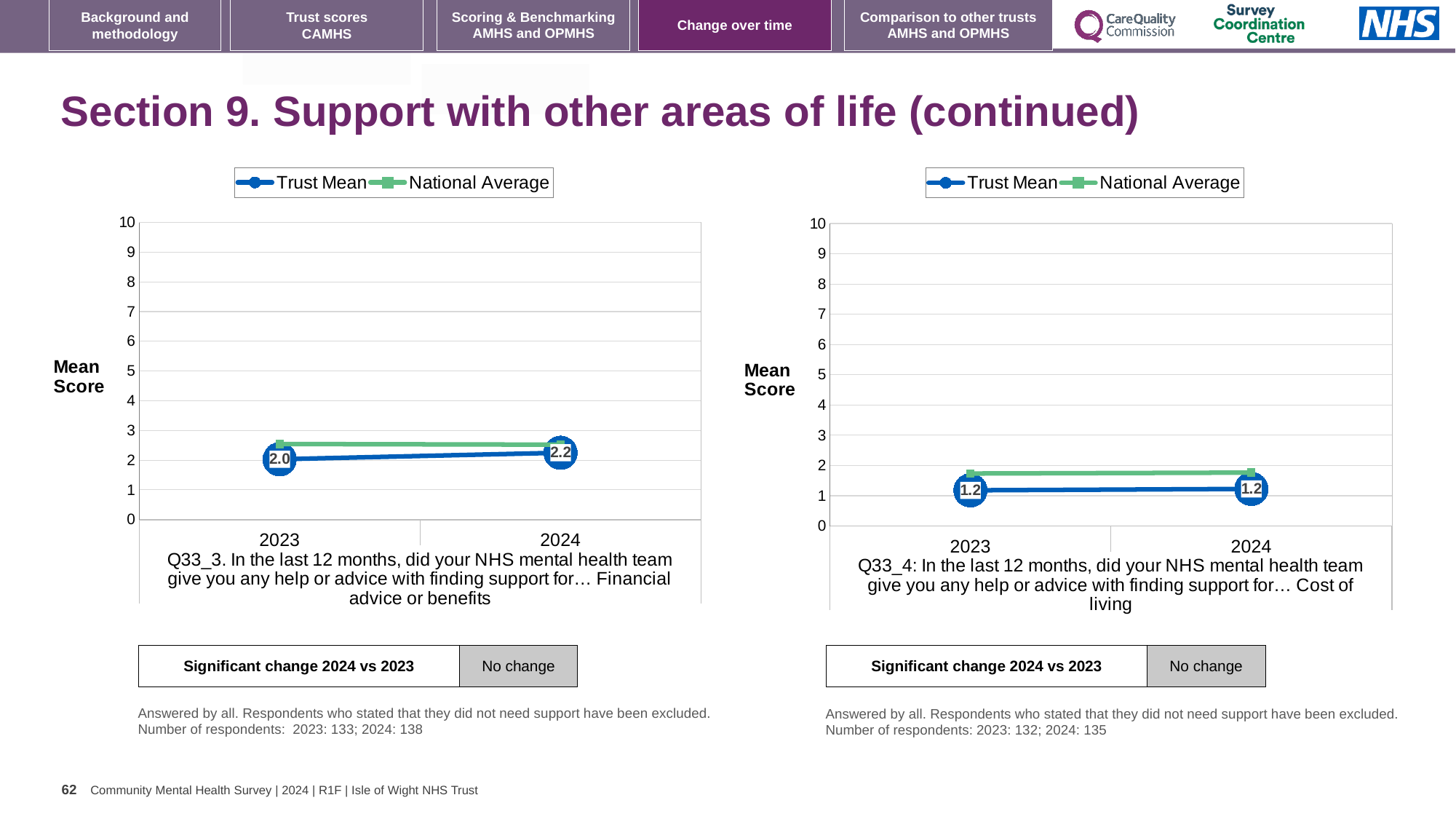
In the left chart (Q33_3, Financial advice or benefits), what is the Trust Mean for 2023? 2.0 In the left chart (Q33_3, Financial advice or benefits), what is the Trust Mean for 2024? 2.2 How many series does the legend of the right chart (Q33_4) list? 2 In the left chart (Q33_3), by how much did the Trust Mean change from 2023 to 2024? 0.2 In the right chart (Q33_4), is the National Average for 2023 greater or less than 2? less In the right chart (Q33_4), does the Trust Mean rise, fall or stay the same from 2023 to 2024? Stays the same How many years are plotted on the x axis of the left chart (Q33_3)? 2 In the right chart (Q33_4, Cost of living), what is the Trust Mean for 2024? 1.2 In the left chart (Q33_3), does the Trust Mean rise or fall from 2023 to 2024? Rise In the left chart (Q33_3), is the National Average for 2024 greater or less than 3? less In the right chart (Q33_4), which is higher in 2023: the Trust Mean or the National Average? National Average What kind of chart is the left chart (Q33_3)? Line chart